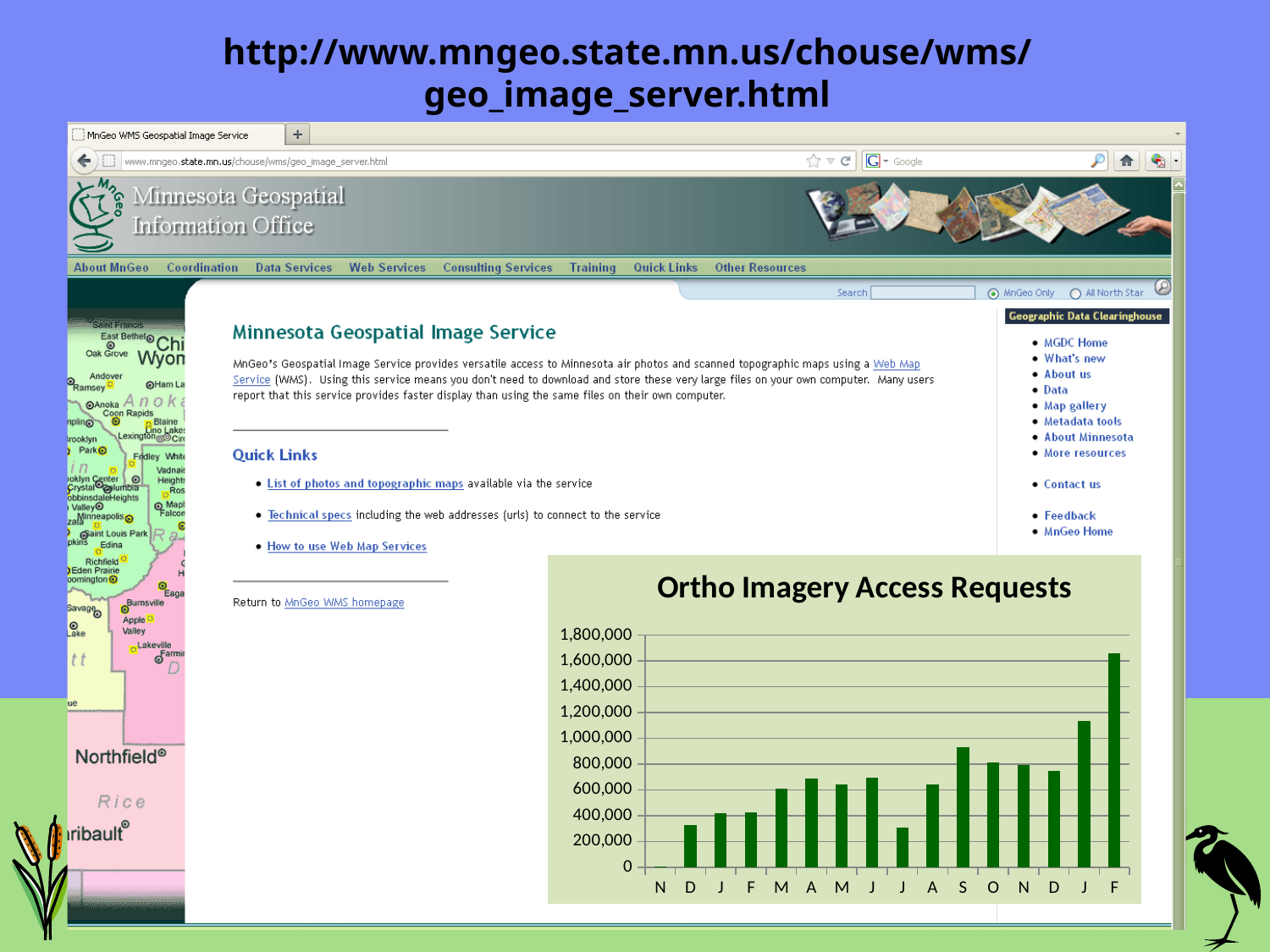
In the Ortho Imagery Access Requests chart, is the value for S greater or less than 800,000? greater In the Ortho Imagery Access Requests chart, which is larger, the last F bar or the last J bar? F Which month has the lowest value in the Ortho Imagery Access Requests chart? N (the first bar) Which month has the highest value in the Ortho Imagery Access Requests chart? F (the last bar) In the Ortho Imagery Access Requests chart, is the value for the last J bar (second from the right) greater or less than 1,000,000? greater In the Ortho Imagery Access Requests chart, is the value for the last F bar greater or less than 1,400,000? greater In the Ortho Imagery Access Requests chart, which is larger, the value for S or the value for O? S How many bars (months) are plotted in the Ortho Imagery Access Requests chart? 16 Overall, do the values in the Ortho Imagery Access Requests chart rise or fall from left to right? rise What kind of chart is the Ortho Imagery Access Requests chart? bar chart What is the title of the chart on the slide? Ortho Imagery Access Requests